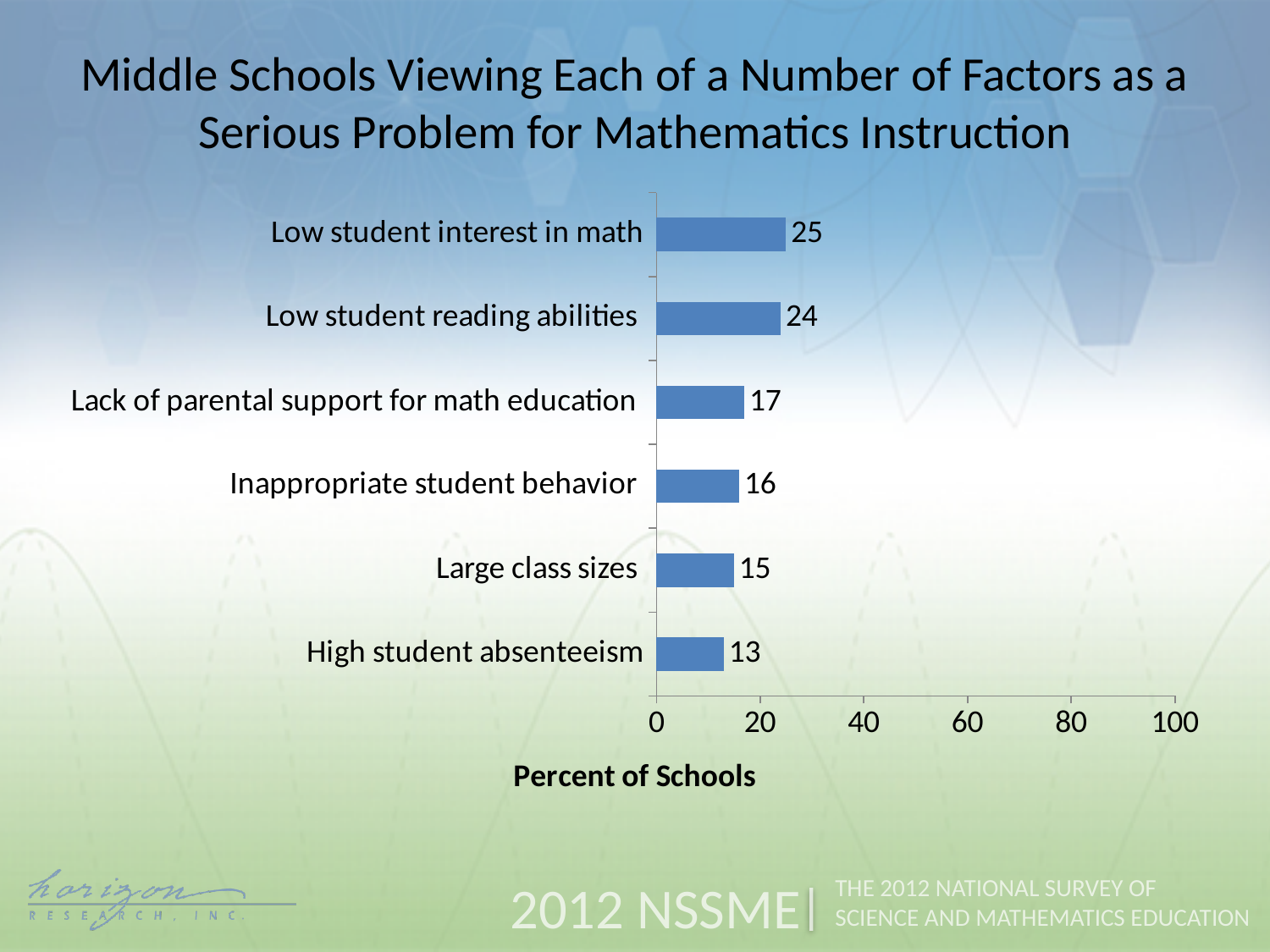
Which is larger: the value for 'Inappropriate student behavior' or the value for 'High student absenteeism'? Inappropriate student behavior How many factors are shown in the chart? 6 Is the value for 'Low student interest in math' greater or less than 40? less Which factor has the highest percent of schools viewing it as a serious problem? Low student interest in math What is the value for 'High student absenteeism'? 13 What percent of middle schools view low student interest in math as a serious problem? 25 What is the difference between the values for 'Low student reading abilities' and 'Large class sizes'? 9 What is the highest tick value shown on the horizontal axis? 100 What is the value for 'Lack of parental support for math education'? 17 What is the label of the horizontal axis? Percent of Schools Which factor has the lowest percent of schools viewing it as a serious problem? High student absenteeism What kind of chart is shown on the slide? Bar chart